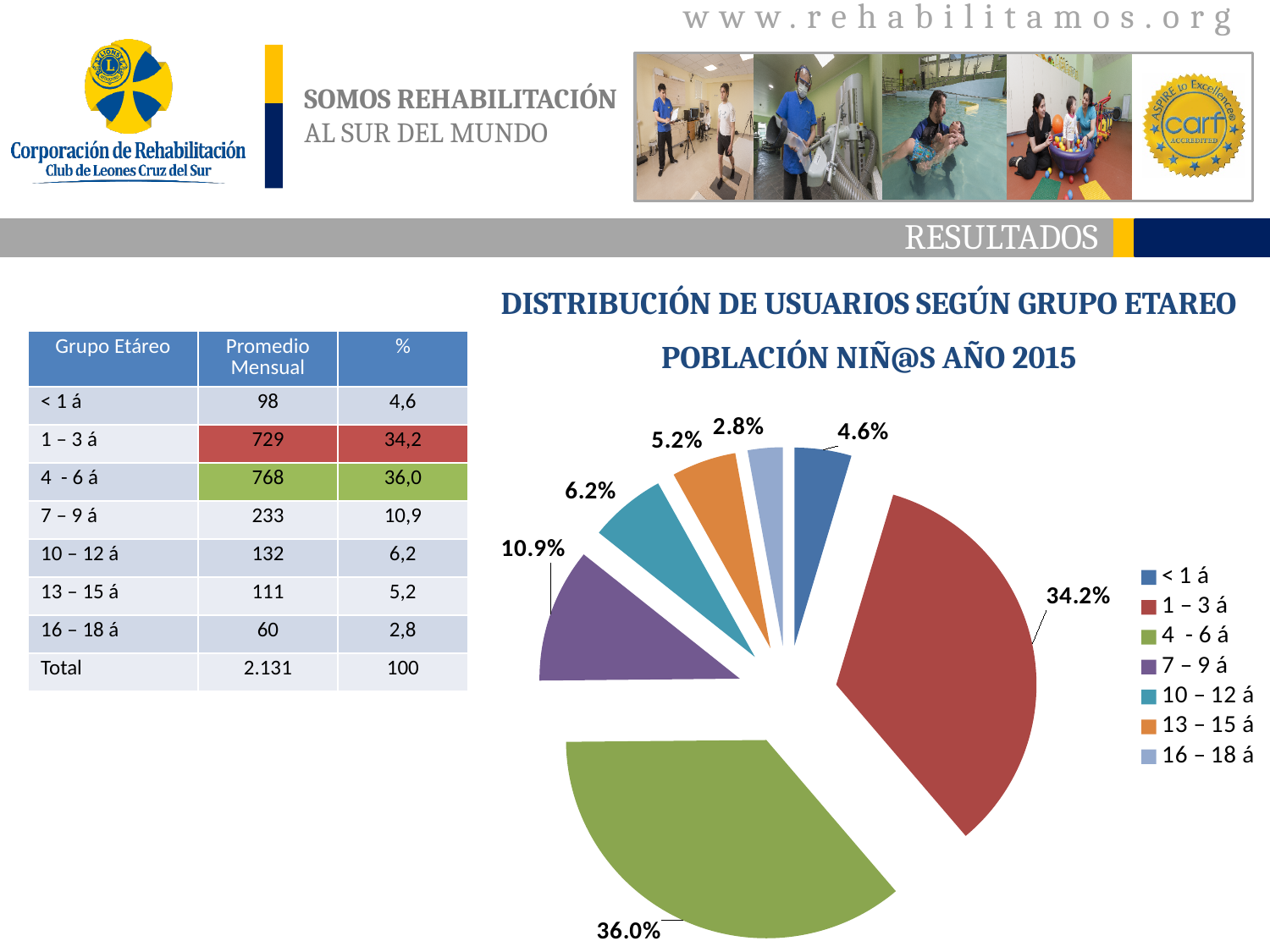
Which age group has the smallest slice of the pie? 16 – 18 á What is the value shown for the 7 – 9 á slice? 10.9% Which slice is larger, 10 – 12 á or 13 – 15 á? 10 – 12 á What is the value shown for the 16 – 18 á slice? 2.8% What kind of chart is shown on the slide? pie chart What is the difference in percentage points between the 4 - 6 á slice and the 1 – 3 á slice? 1.8 How many entries does the legend list? 7 Which age group has the largest slice of the pie? 4 - 6 á How many age groups are shown in the pie chart? 7 What colour is the slice for the 1 – 3 á group? red What share of the pie does the 4 - 6 á group have? 36.0% What share of the pie does the 1 – 3 á group have? 34.2%